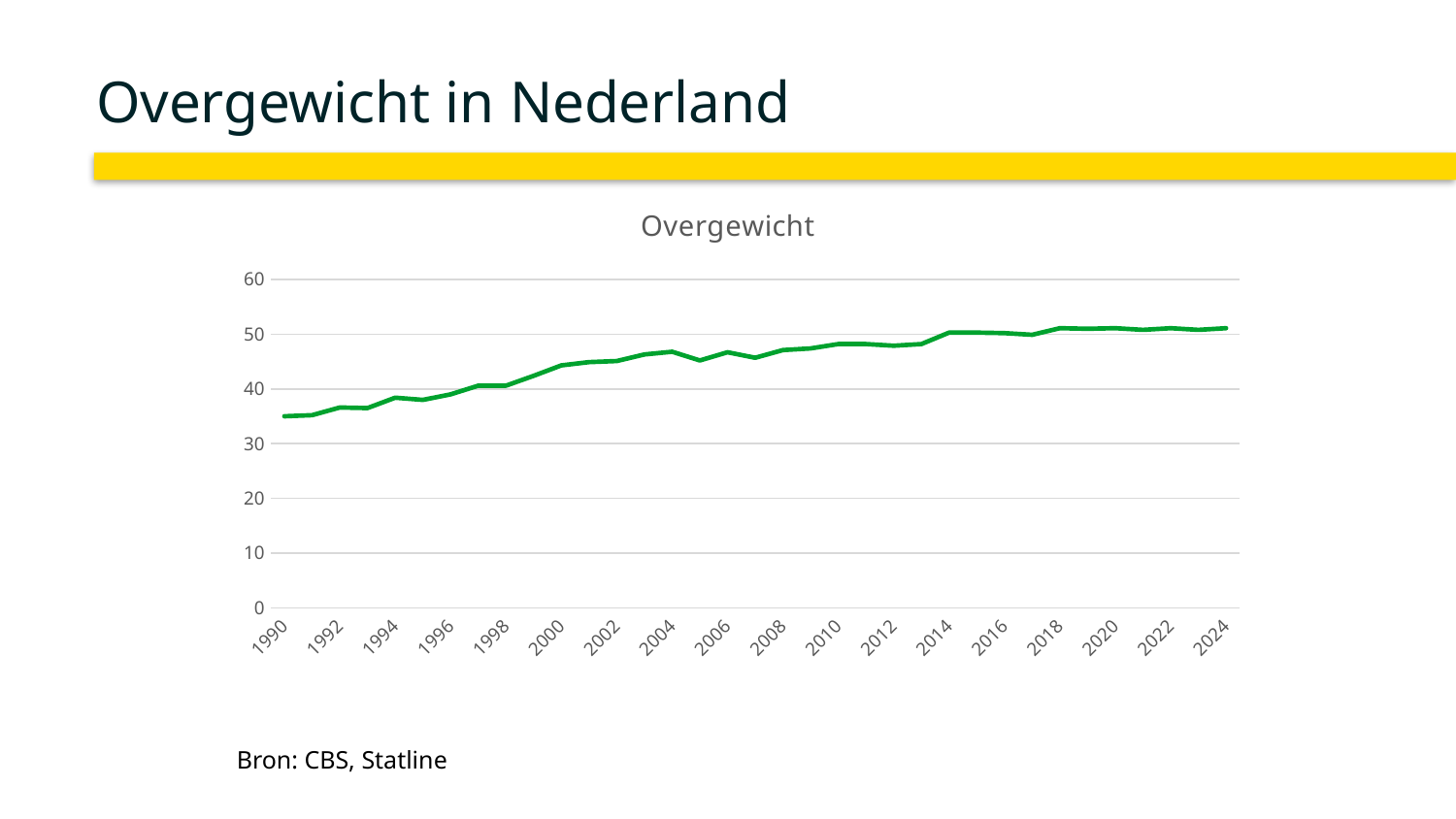
Is the value for 2002 greater or less than 40? greater Is the value for 2010 greater or less than 50? less Is the value for 1992 greater or less than 30? greater What kind of chart is shown on the slide? line chart Which is larger, the value for 2020 or the value for 1994? 2020 Do the values generally rise or fall from 1990 to 2024? rise Which year has the lowest value on the chart? 1990 What is the source cited below the chart? Bron: CBS, Statline What is the title of the chart? Overgewicht